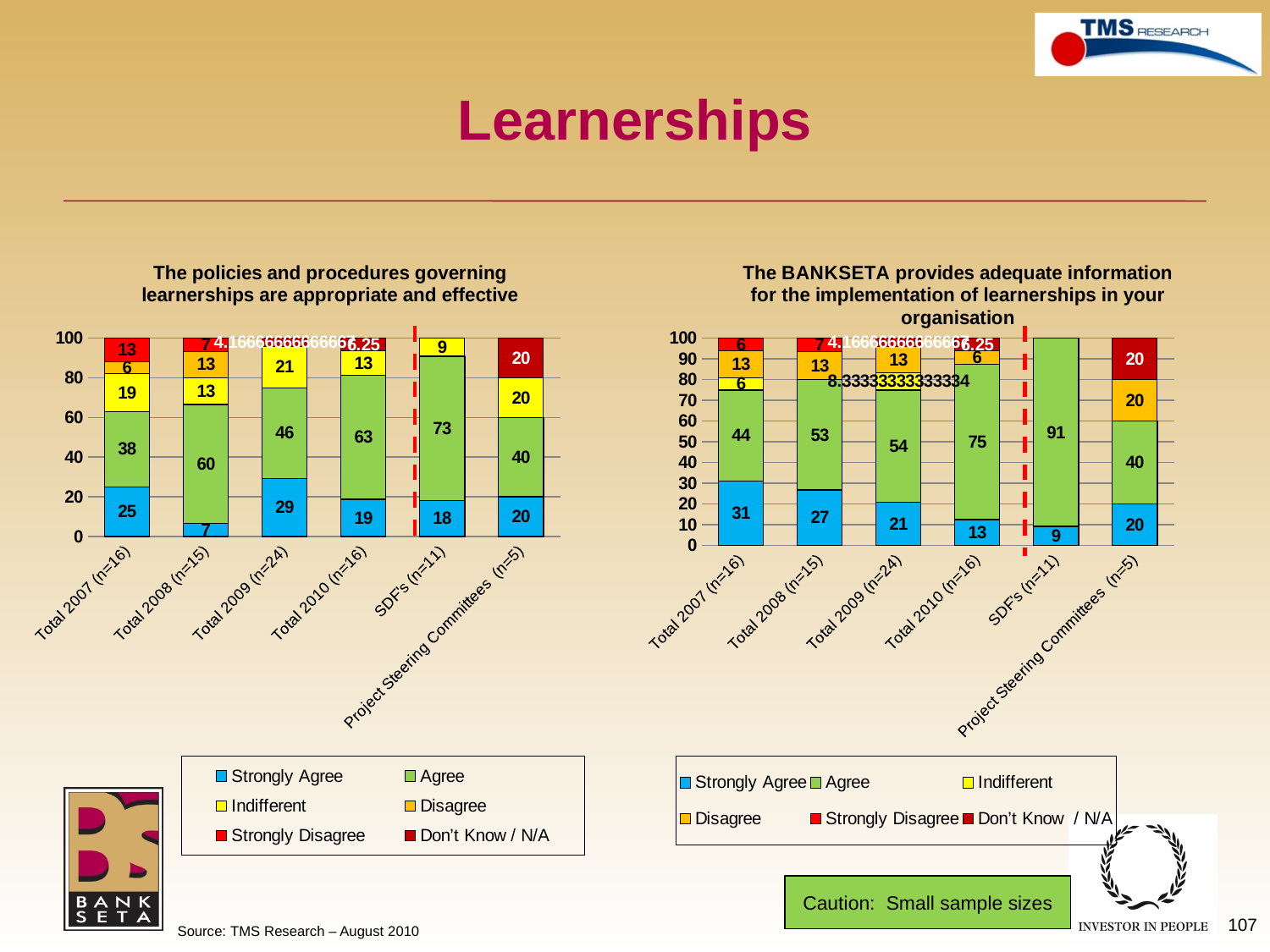
In the left chart (policies and procedures governing learnerships), which category has the highest Agree value? SDF's (n=11) In the left chart (policies and procedures governing learnerships), which is larger: the Agree value for Total 2008 (n=15) or for Total 2009 (n=24)? Total 2008 (n=15) How many categories are shown on the x axis of the right chart (BANKSETA provides adequate information)? 6 How many series does the legend of the left chart (policies and procedures governing learnerships) list? 6 In the right chart (BANKSETA provides adequate information), what is the difference between the Agree values for Total 2010 (n=16) and Total 2009 (n=24)? 21 In the right chart (BANKSETA provides adequate information), what is the Strongly Agree value for Total 2010 (n=16)? 13 In the left chart (policies and procedures governing learnerships), what is the Strongly Agree value for Total 2009 (n=24)? 29 In the right chart (BANKSETA provides adequate information), what is the Agree value for SDF's (n=11)? 91 In the left chart (policies and procedures governing learnerships), what is the Agree value for SDF's (n=11)? 73 What type of chart is used for the left chart (policies and procedures governing learnerships)? Stacked bar chart In the right chart (BANKSETA provides adequate information), which category has the highest Strongly Agree value? Total 2007 (n=16) In the left chart (policies and procedures governing learnerships), which category has the lowest Strongly Agree value? Total 2008 (n=15)